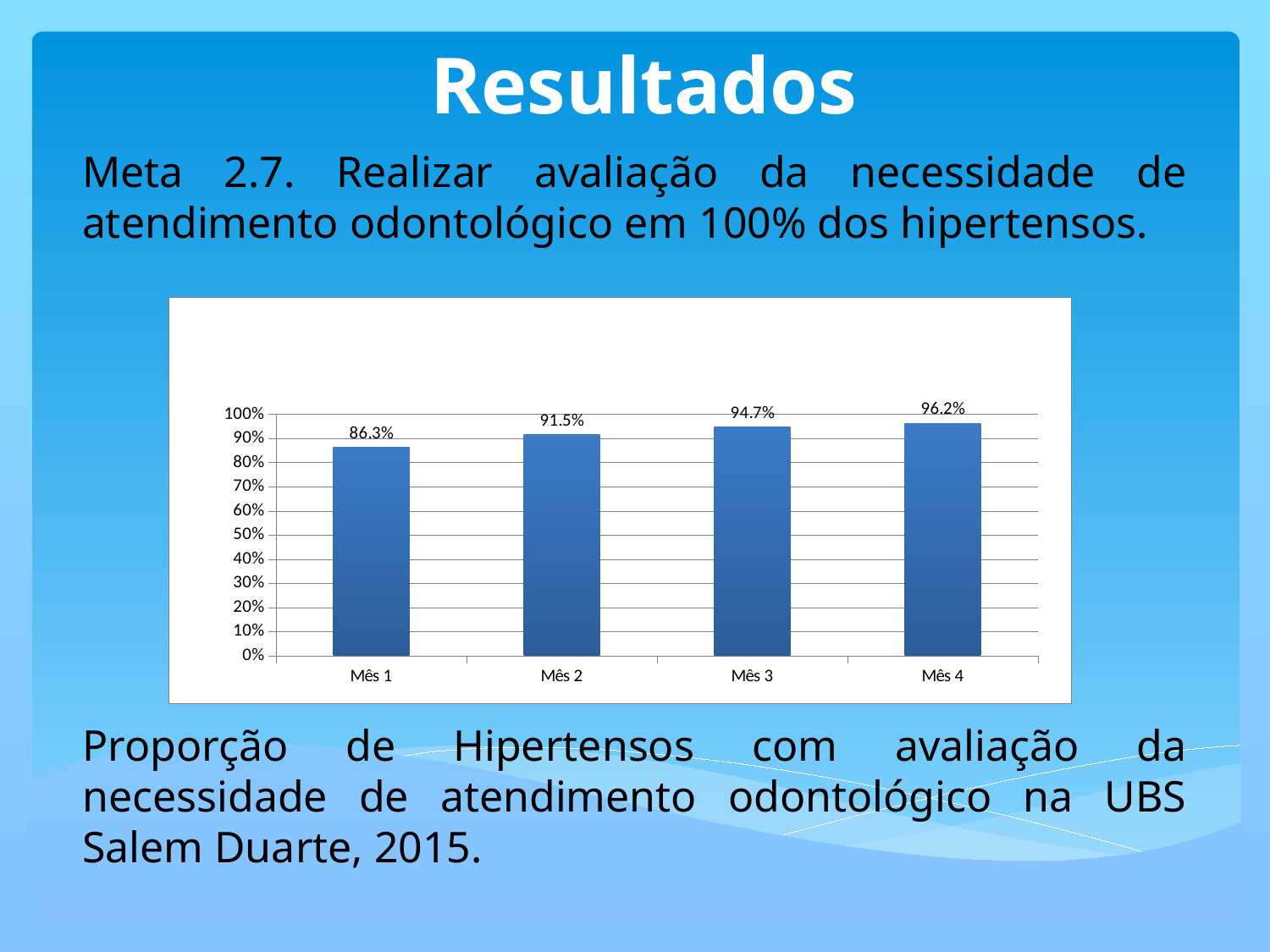
Which is larger, the value for Mês 2 or the value for Mês 3? Mês 3 Which month has the lowest value? Mês 1 What is the difference between the values for Mês 4 and Mês 1? 9.9% What is the value for Mês 2? 91.5% What is the value for Mês 1? 86.3% Which month has the highest value? Mês 4 Is the value for Mês 1 greater or less than 90%? less What is the difference between the values for Mês 2 and Mês 1? 5.2% What is the value for Mês 3? 94.7% How many months are shown on the x axis? 4 What kind of chart is shown on the slide? bar chart What is the value for Mês 4? 96.2%